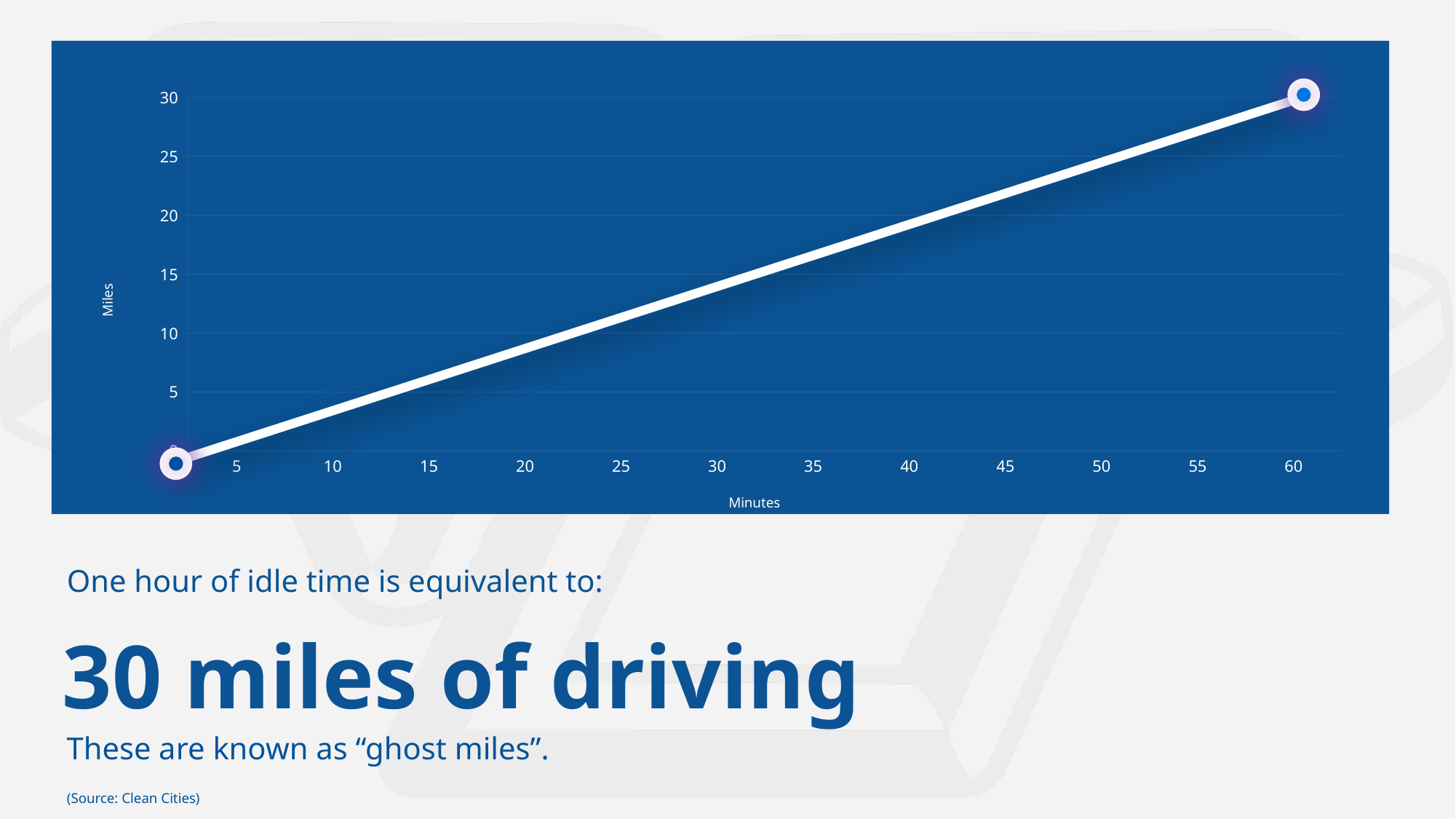
Is the value of the line at 45 minutes greater or less than 20 miles? greater What is the value in miles at 60 minutes? 30 Which is larger, the value at 60 minutes or the value at 0 minutes? 60 minutes At which x-axis value is the plotted value highest? 60 What is the label of the x axis? Minutes What is the label of the y axis? Miles Is the value of the line at 30 minutes greater or less than 20 miles? less What kind of chart is shown on the slide? line chart At which x-axis value is the plotted value lowest? 0 How many data points are plotted on the line? 2 What is the value in miles at 0 minutes? 0 Do the values rise or fall as minutes increase along the x axis? rise